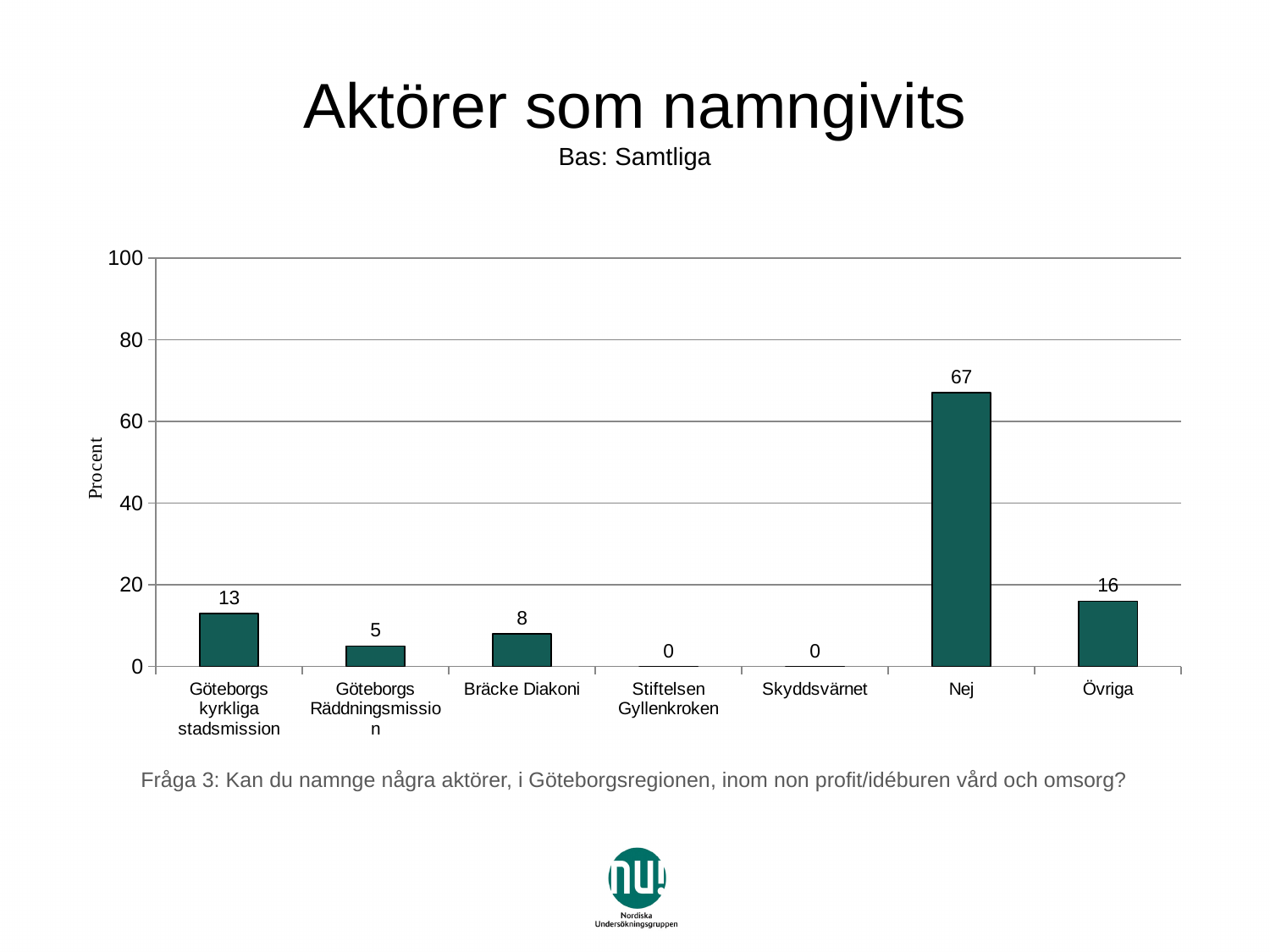
What is the difference between the values for Övriga and Göteborgs Räddningsmission? 11 How many categories have a value of 0? 2 What is the value for Nej? 67 What is the value for Bräcke Diakoni? 8 What is the label of the y axis? Procent Which category has the highest value? Nej Which is larger, the value for Göteborgs kyrkliga stadsmission or the value for Bräcke Diakoni? Göteborgs kyrkliga stadsmission What is the value for Övriga? 16 What kind of chart is shown on the slide? bar chart What is the value for Göteborgs kyrkliga stadsmission? 13 How many categories are shown on the x axis? 7 Is the value for Nej greater or less than 60? greater